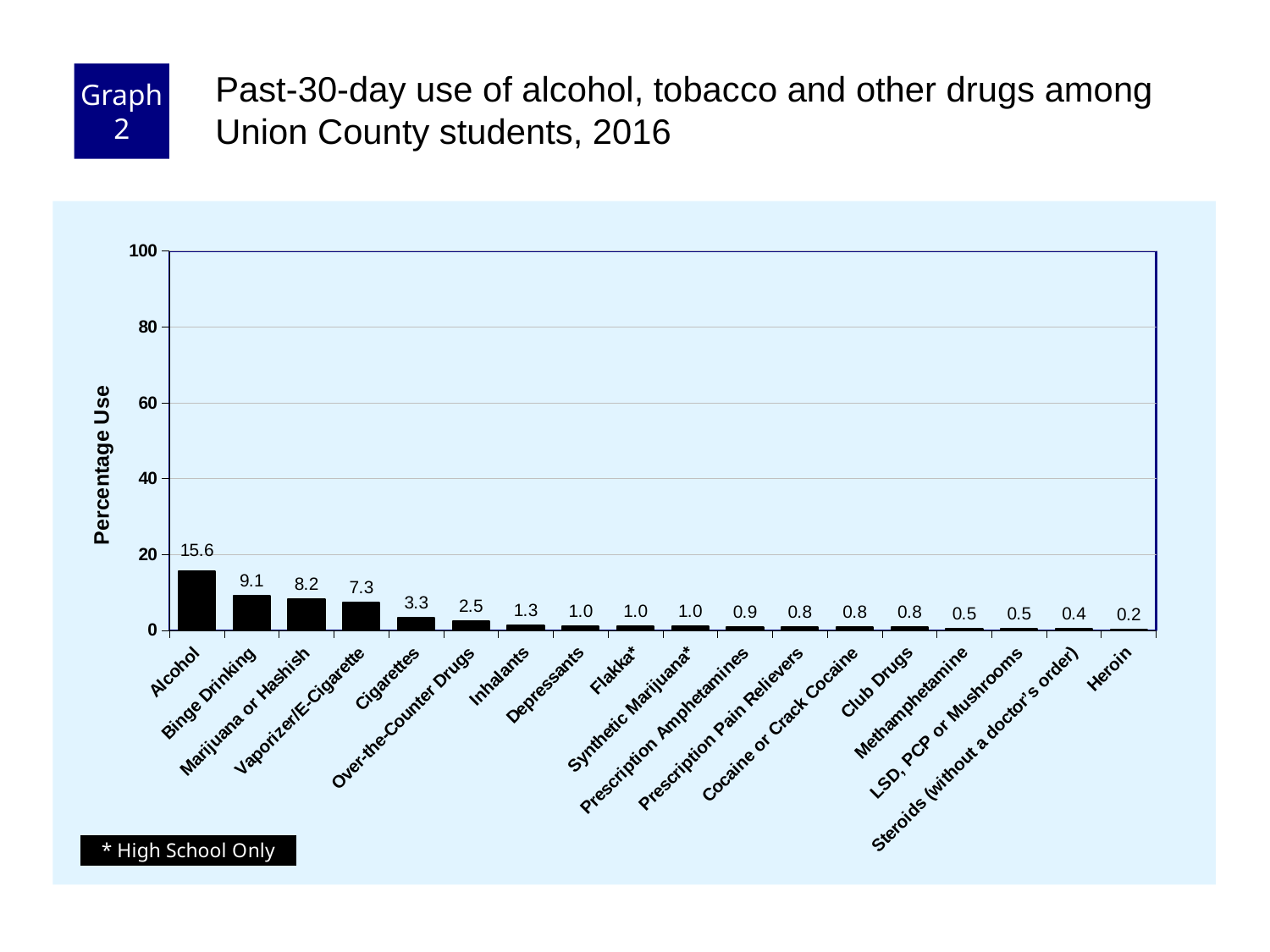
How many categories are shown on the x axis? 18 Which category has the lowest percentage use? Heroin What is the difference in percentage use between Marijuana or Hashish and Cigarettes? 4.9 Is the value for Alcohol greater or less than 20? less What kind of chart is shown on the slide? Bar chart What is the difference in percentage use between Alcohol and Binge Drinking? 6.5 What is the percentage use for Heroin? 0.2 Which has a higher percentage use, Over-the-Counter Drugs or Inhalants? Over-the-Counter Drugs What is the percentage use for Alcohol? 15.6 What is the percentage use for Cigarettes? 3.3 What is the percentage use for Vaporizer/E-Cigarette? 7.3 Which category has the highest percentage use? Alcohol